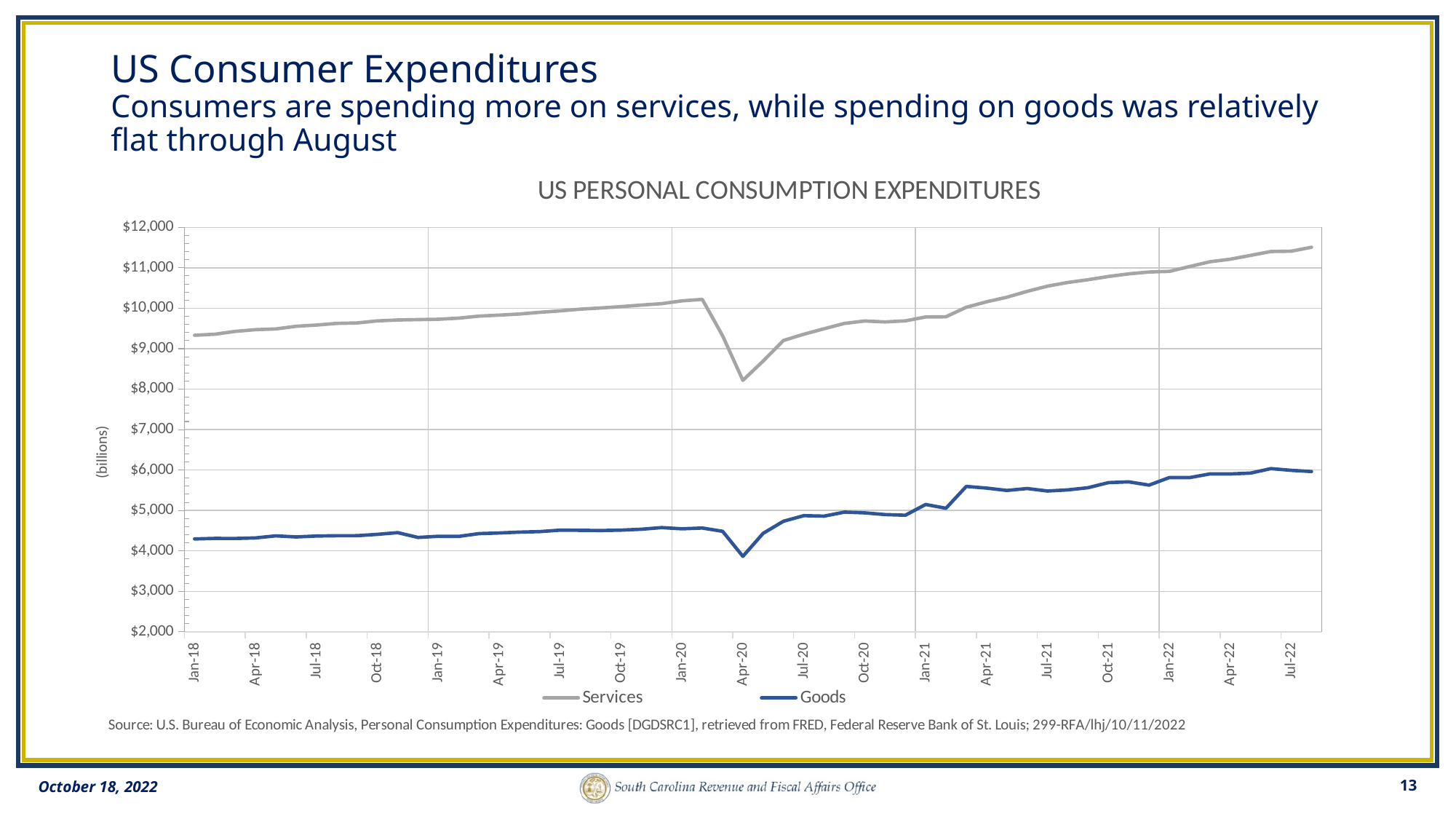
Is the value for Goods in Apr-20 greater or less than $4,000? less Which series has the higher value in Jan-21, Services or Goods? Services What unit is shown on the vertical axis label? (billions) Is the value for Services in Apr-20 greater or less than $9,000? less Does the Services series rise or fall overall from Jan-18 to Jul-22? rise Is the value for Goods in Jan-18 greater or less than $4,000? greater What is the title of the chart? US PERSONAL CONSUMPTION EXPENDITURES What kind of chart is shown on the slide? line chart How many series does the legend list? 2